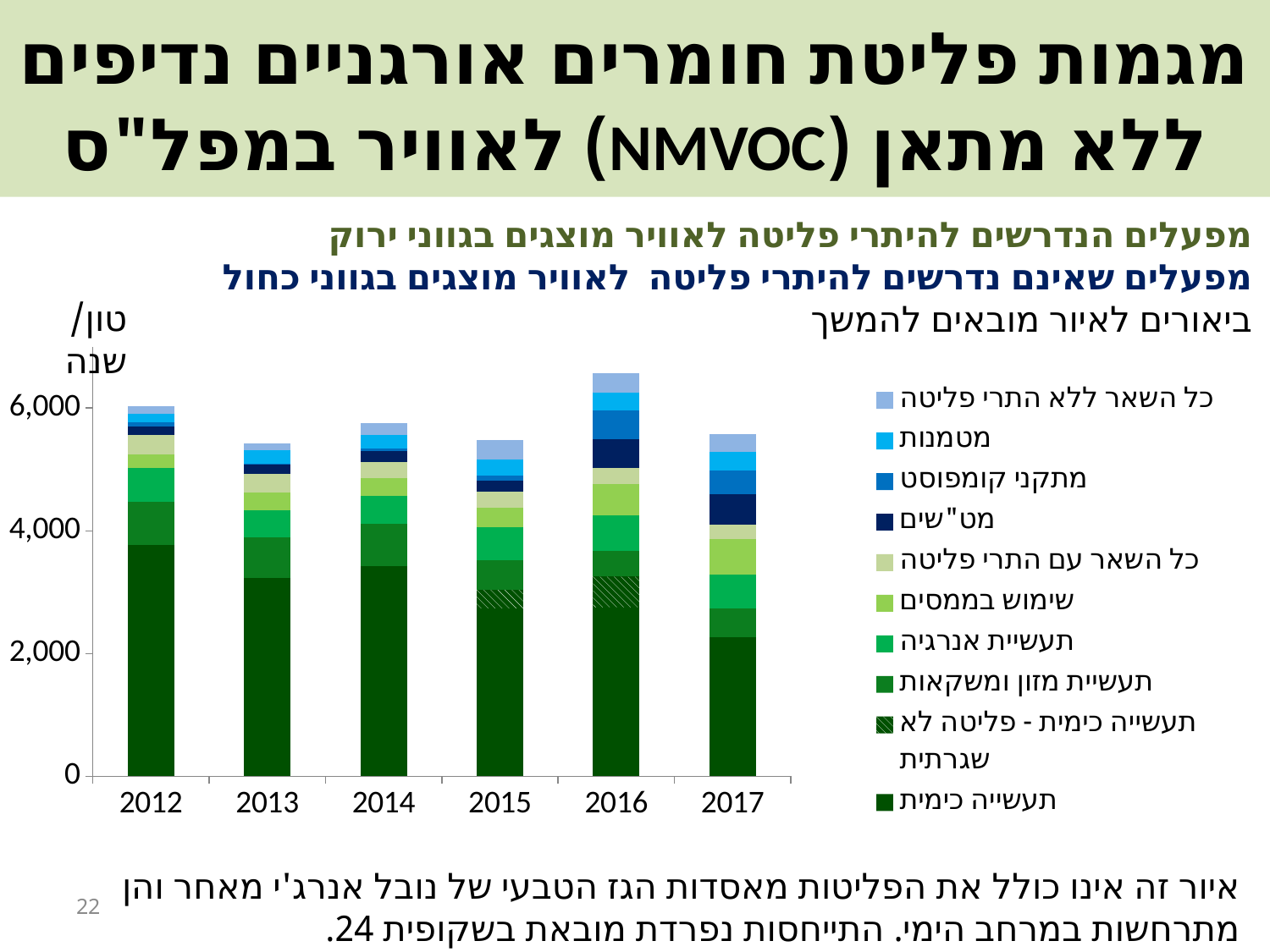
What kind of chart is shown on the slide? Stacked bar chart Does the total bar rise or fall from 2016 to 2017? fall Which year has the larger total bar, 2016 or 2013? 2016 Which legend entry is drawn with a hatched pattern? תעשייה כימית - פליטה לא שגרתית Is the total for 2017 greater or less than 6,000? less Is the total for 2016 greater or less than 6,000? greater What unit label is shown at the top of the y axis? טון/שנה Is the total for 2013 greater or less than 6,000? less How many series does the chart's legend list? 10 Which year has the highest total stacked bar? 2016 How many years are shown on the x axis of the chart? 6